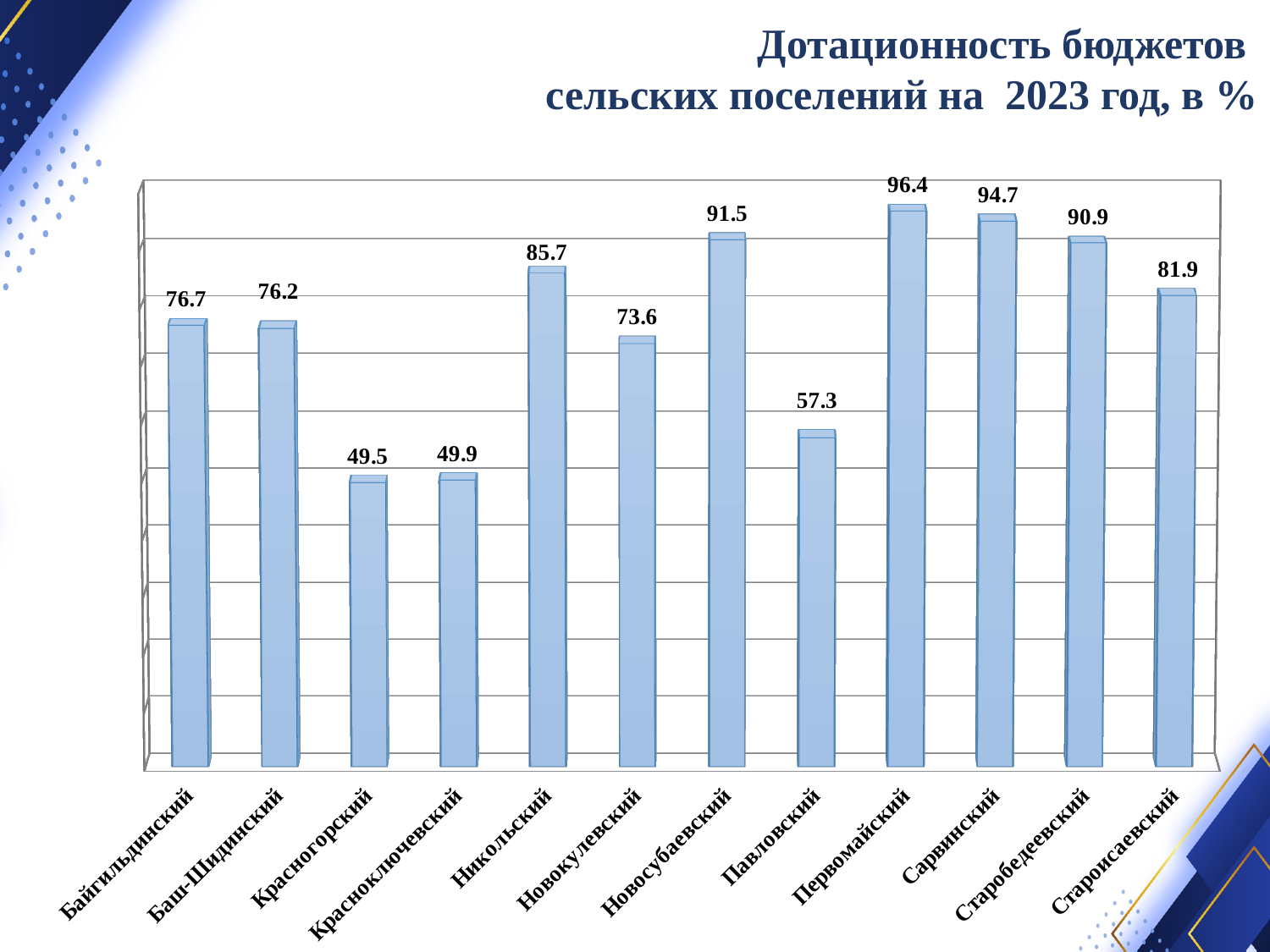
What is the difference between the values for Новосубаевский and Павловский? 34.2 What is the value for Первомайский? 96.4 Which category has the lowest value? Красногорский What is the value for Новокулевский? 73.6 Which is larger, the value for Никольский or the value for Новокулевский? Никольский What is the value for Красноключевский? 49.9 What is the difference between the values for Первомайский and Красногорский? 46.9 How many categories are shown in the chart? 12 What is the value for Старобедеевский? 90.9 What is the title of the chart? Дотационность бюджетов сельских поселений на 2023 год, в % What kind of chart is shown on the slide? Bar chart Which category has the highest value? Первомайский